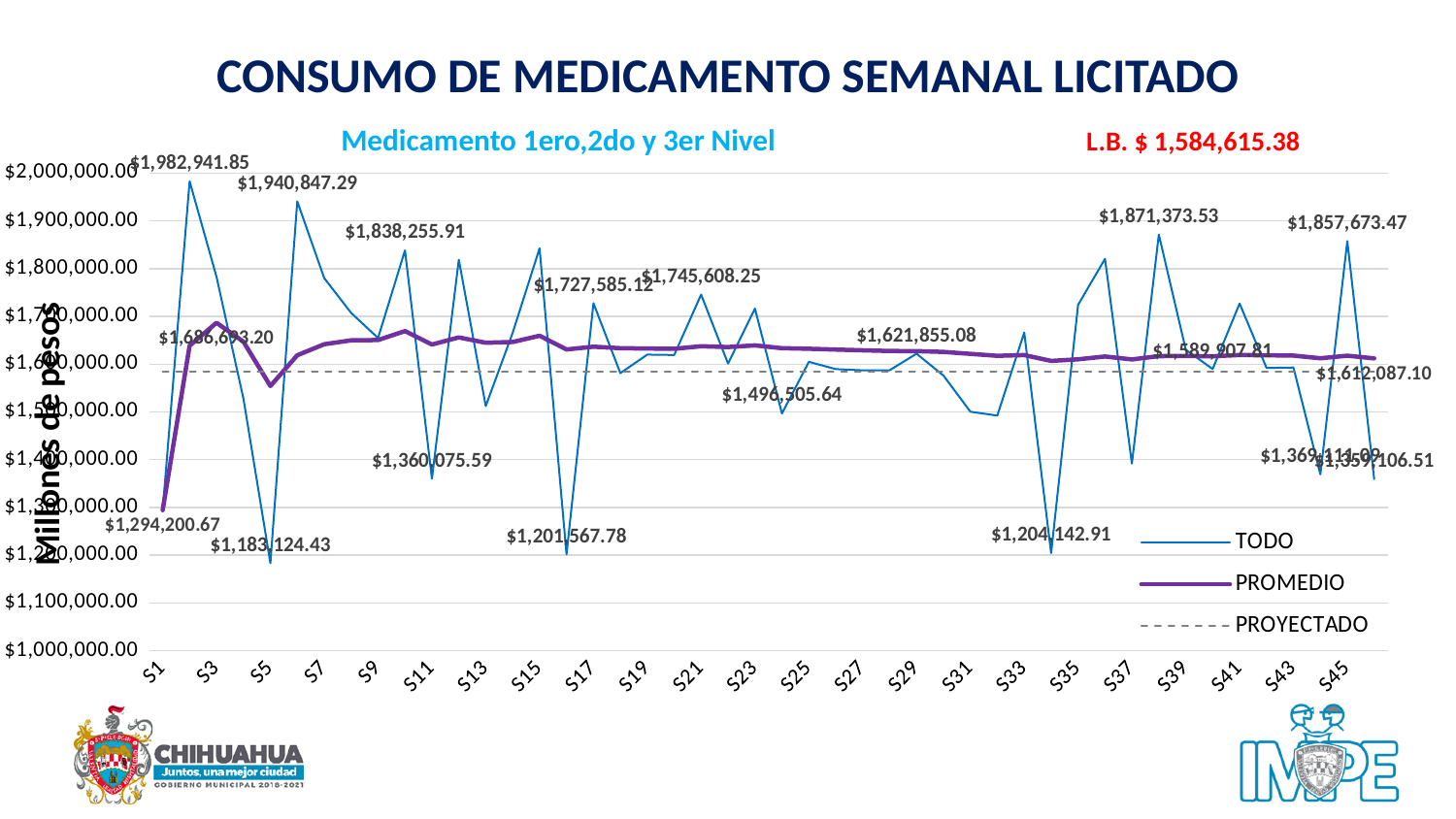
What L.B. value is printed in red on the slide? $ 1,584,615.38 How many series does the legend list? 3 What kind of chart is shown on the slide? line chart What is the value of the TODO series at S34? $1,204,142.91 Which is larger, the TODO value at S2 or at S6? S2 What is the value of the TODO series at S1? $1,294,200.67 Which week has the lowest value in the TODO series? S5 Which week has the highest value in the TODO series? S2 What is the value of the TODO series at S5? $1,183,124.43 Is the TODO value at S7 greater or less than $1,700,000.00? greater What is the value of the TODO series at S38? $1,871,373.53 What is the difference between the highest TODO value ($1,982,941.85) and the lowest TODO value ($1,183,124.43)? $799,817.42